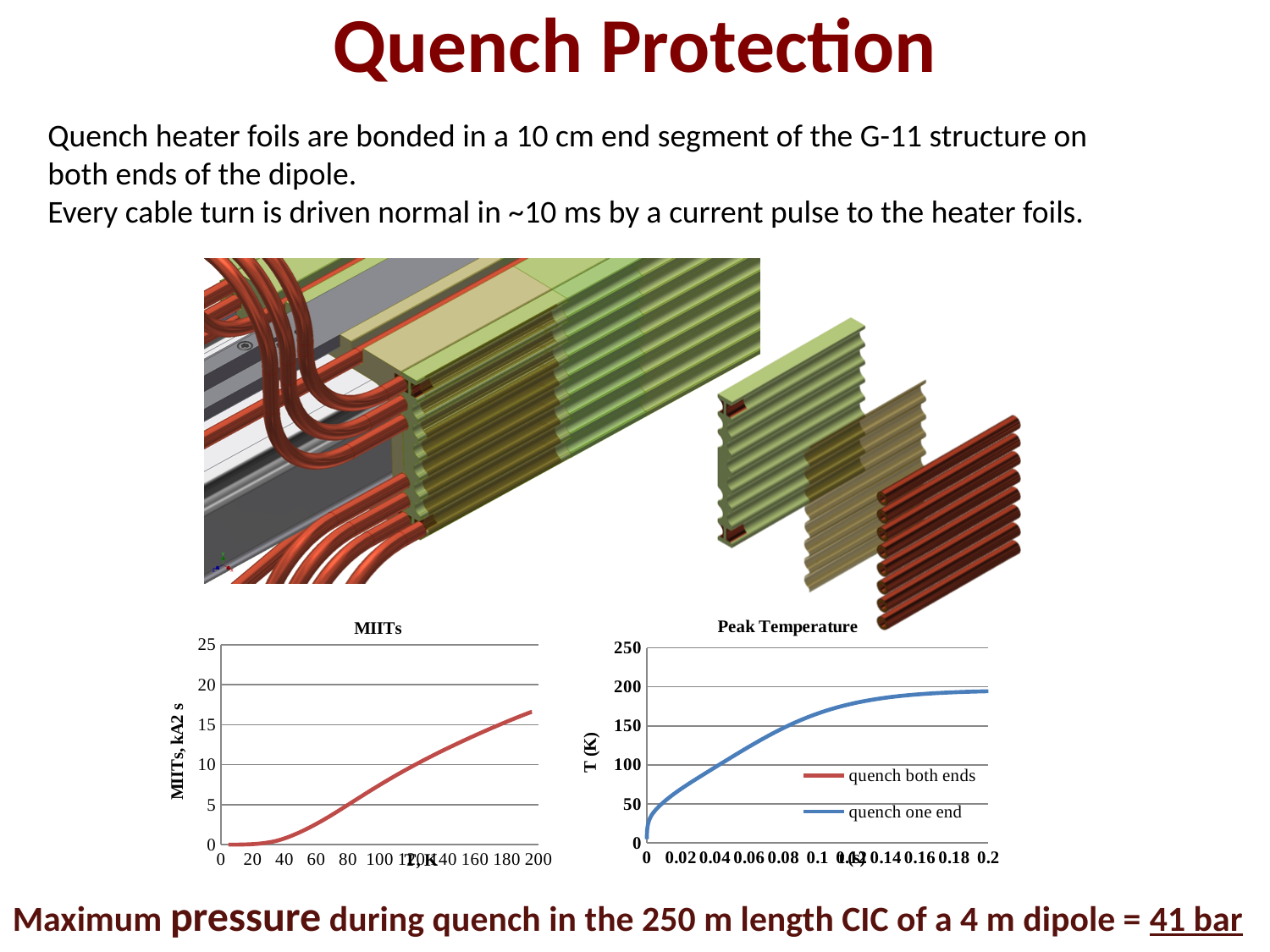
What are the two legend entries in the Peak Temperature chart? quench both ends, quench one end In the Peak Temperature chart, is the temperature at t = 0.1 s greater or less than 150? greater In the MIITs chart, is the value at T = 40 K greater or less than 5? less What is the y-axis label of the MIITs chart? MIITs, kA2 s In the Peak Temperature chart, does the plotted temperature rise or fall as t (s) increases? rise In the MIITs chart, do the values rise or fall as T increases along the x axis? rise In the Peak Temperature chart, is the temperature at t = 0.02 s greater or less than 50? greater What kind of chart is the Peak Temperature chart? line chart How many series does the legend of the Peak Temperature chart list? 2 What kind of chart is the MIITs chart? line chart